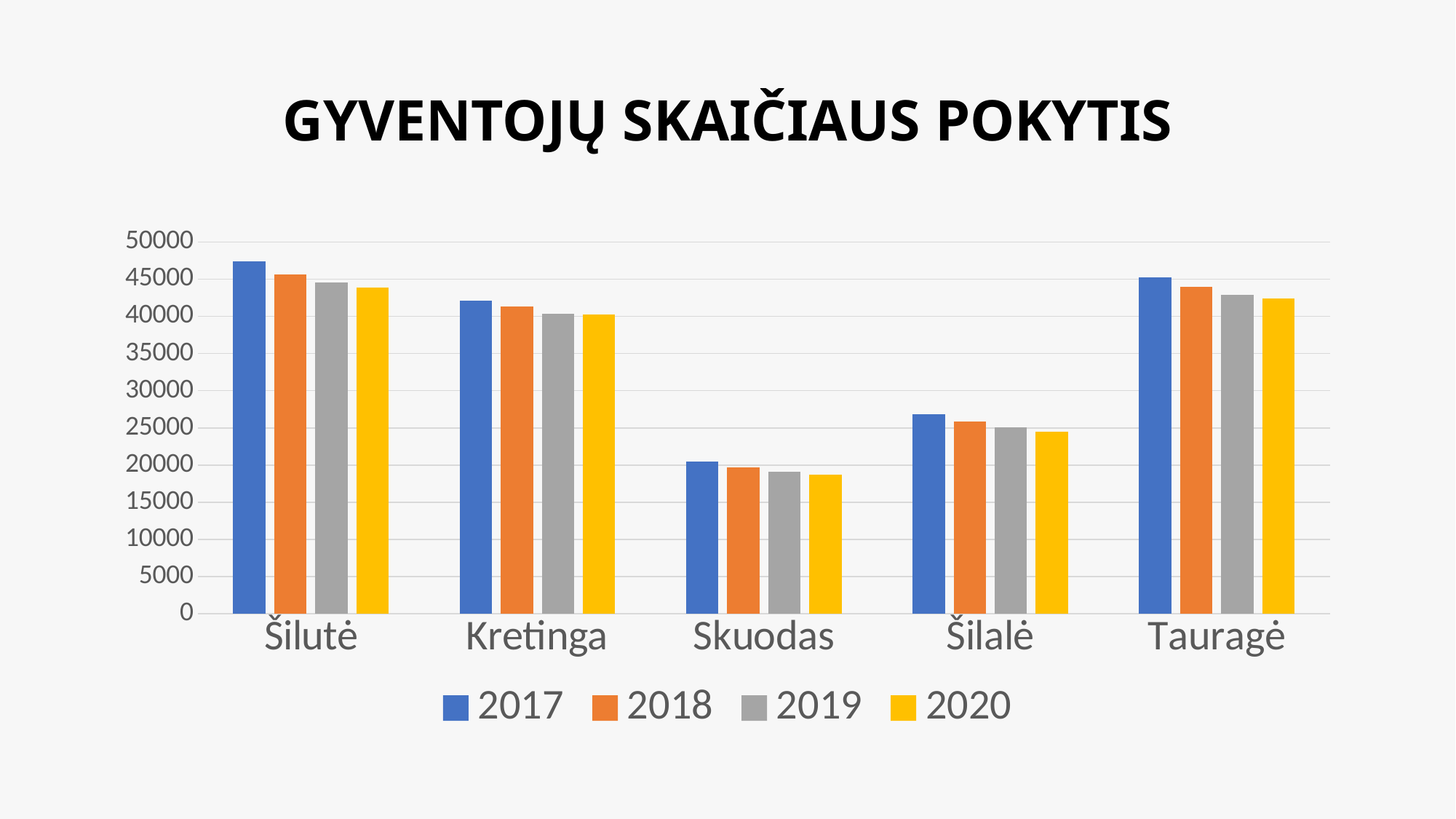
Is the value for Šilutė in 2017 greater or less than 45000? greater For Šilutė, do the values rise or fall from 2017 to 2020? fall Is the value for Kretinga in 2017 greater or less than 40000? greater Which town has the lowest value for 2020? Skuodas Which town has the highest value for 2017? Šilutė Is the value for Skuodas in 2020 greater or less than 20000? less Which is larger, the 2017 value for Šilutė or the 2017 value for Tauragė? Šilutė What kind of chart is shown on the slide? bar chart How many categories (towns) are shown on the x axis? 5 What is the title of the chart? GYVENTOJŲ SKAIČIAUS POKYTIS How many series does the legend list? 4